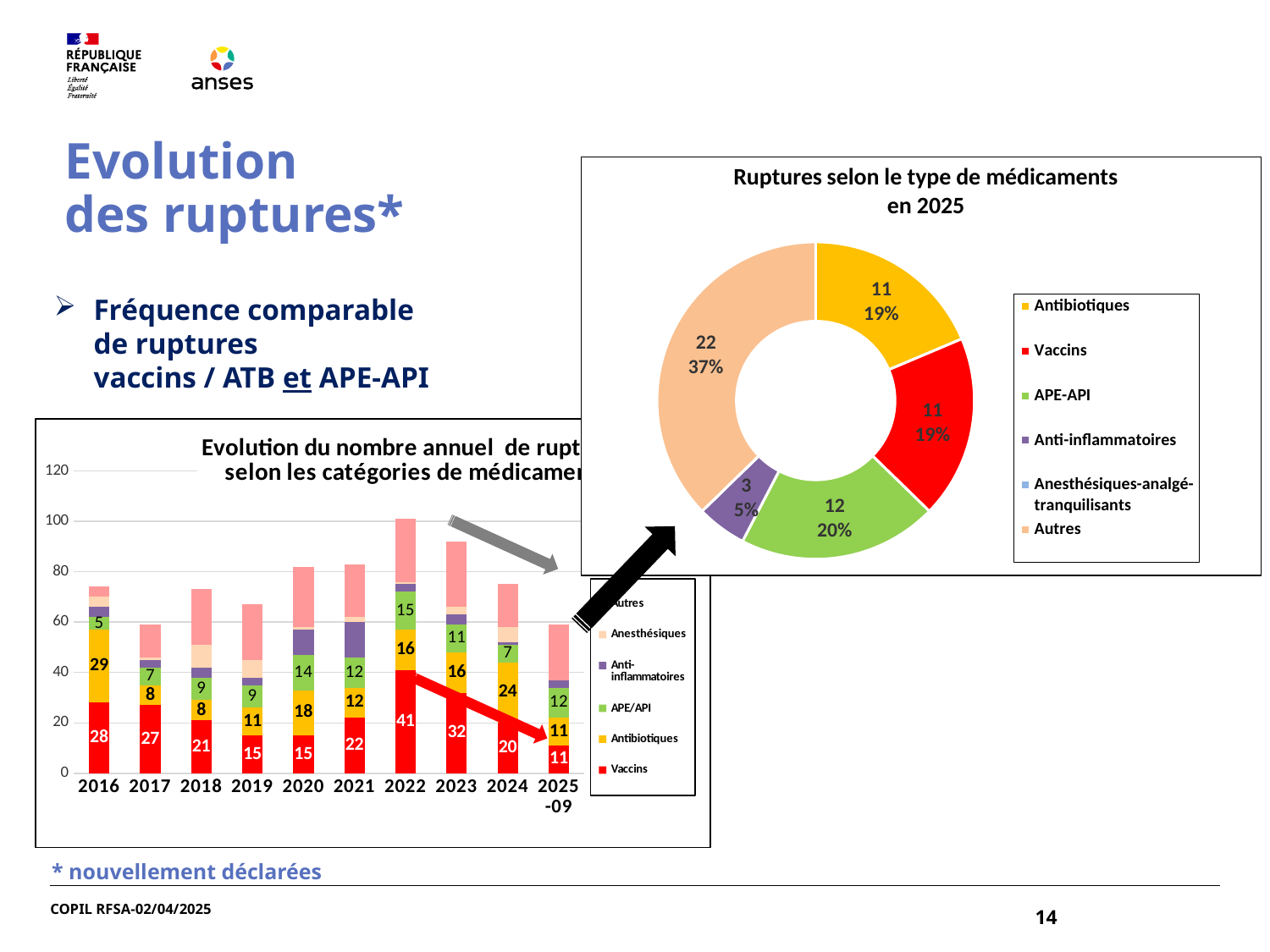
How many years (categories) are shown on the x axis of the stacked bar chart at the bottom left? 10 In the doughnut chart 'Ruptures selon le type de médicaments en 2025', which category has the smallest visible slice? Anti-inflammatoires In the stacked bar chart at the bottom left, which year has the highest Vaccins value? 2022 In the stacked bar chart at the bottom left, what is the Vaccins value for 2022? 41 In the doughnut chart 'Ruptures selon le type de médicaments en 2025', what is the difference between the Autres value and the Anti-inflammatoires value? 19 How many entries does the legend of the doughnut chart 'Ruptures selon le type de médicaments en 2025' list? 6 In the doughnut chart 'Ruptures selon le type de médicaments en 2025', what percentage share does APE-API have? 20% In the doughnut chart 'Ruptures selon le type de médicaments en 2025', what value is shown for Autres? 22 In the stacked bar chart at the bottom left, is the Vaccins value for 2023 larger or smaller than the Vaccins value for 2024? larger In the stacked bar chart at the bottom left, what is the Antibiotiques value for 2024? 24 In the doughnut chart 'Ruptures selon le type de médicaments en 2025', which category has the largest slice? Autres